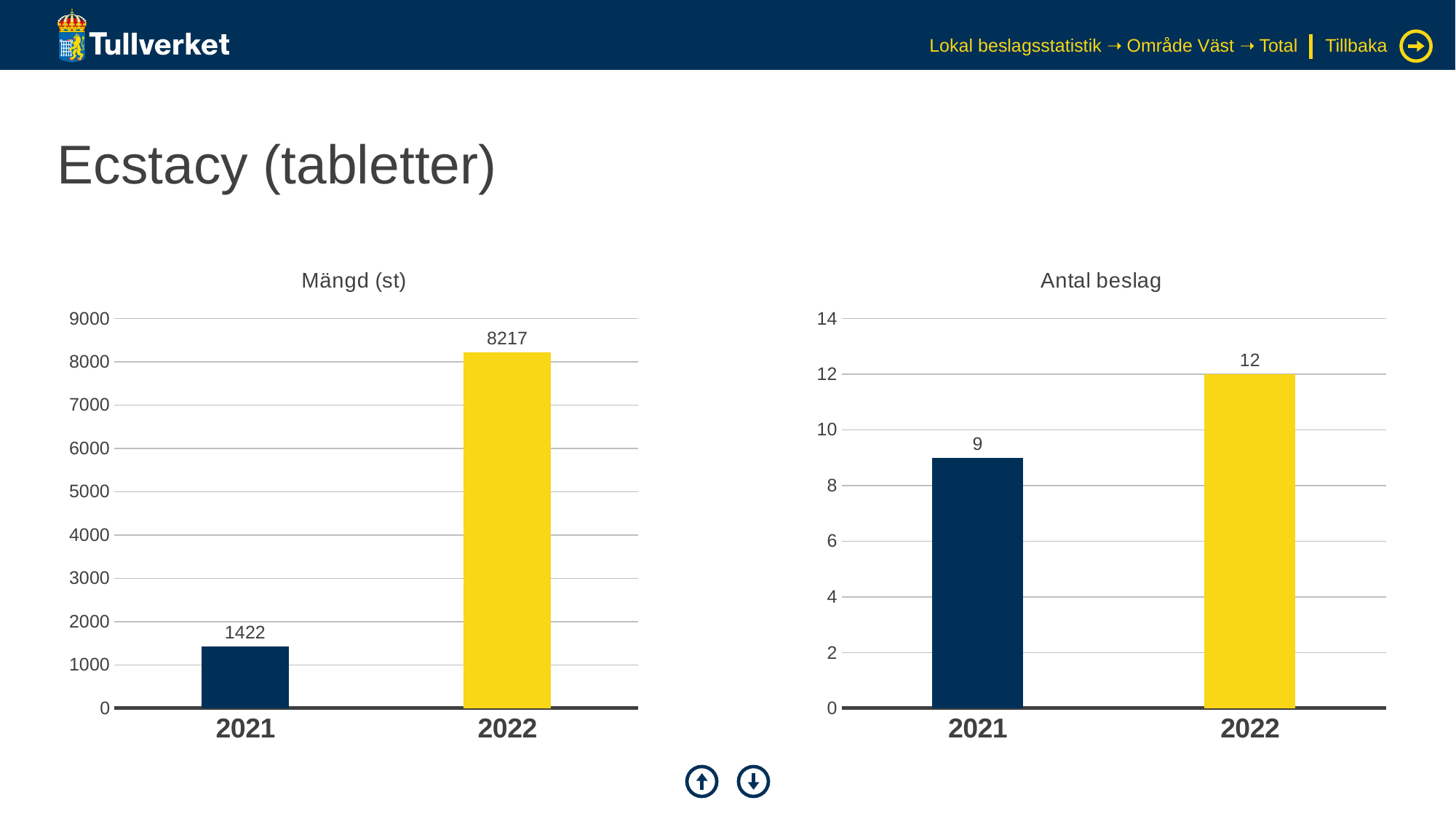
What kind of chart is the 'Antal beslag' chart? bar chart In the 'Antal beslag' chart, is the value for 2021 greater or less than 10? less In the 'Antal beslag' chart, what is the value for 2022? 12 In the 'Mängd (st)' chart, do the values rise or fall from 2021 to 2022? rise In the 'Mängd (st)' chart, what is the value for 2022? 8217 In the 'Antal beslag' chart, what is the difference between the 2022 and 2021 values? 3 In the 'Antal beslag' chart, which year has the lowest value? 2021 How many categories are shown on the x axis of the 'Mängd (st)' chart? 2 In the 'Mängd (st)' chart, what is the difference between the 2022 and 2021 values? 6795 In the 'Mängd (st)' chart, what is the value for 2021? 1422 In the 'Mängd (st)' chart, which year has the highest value? 2022 In the 'Antal beslag' chart, what is the value for 2021? 9